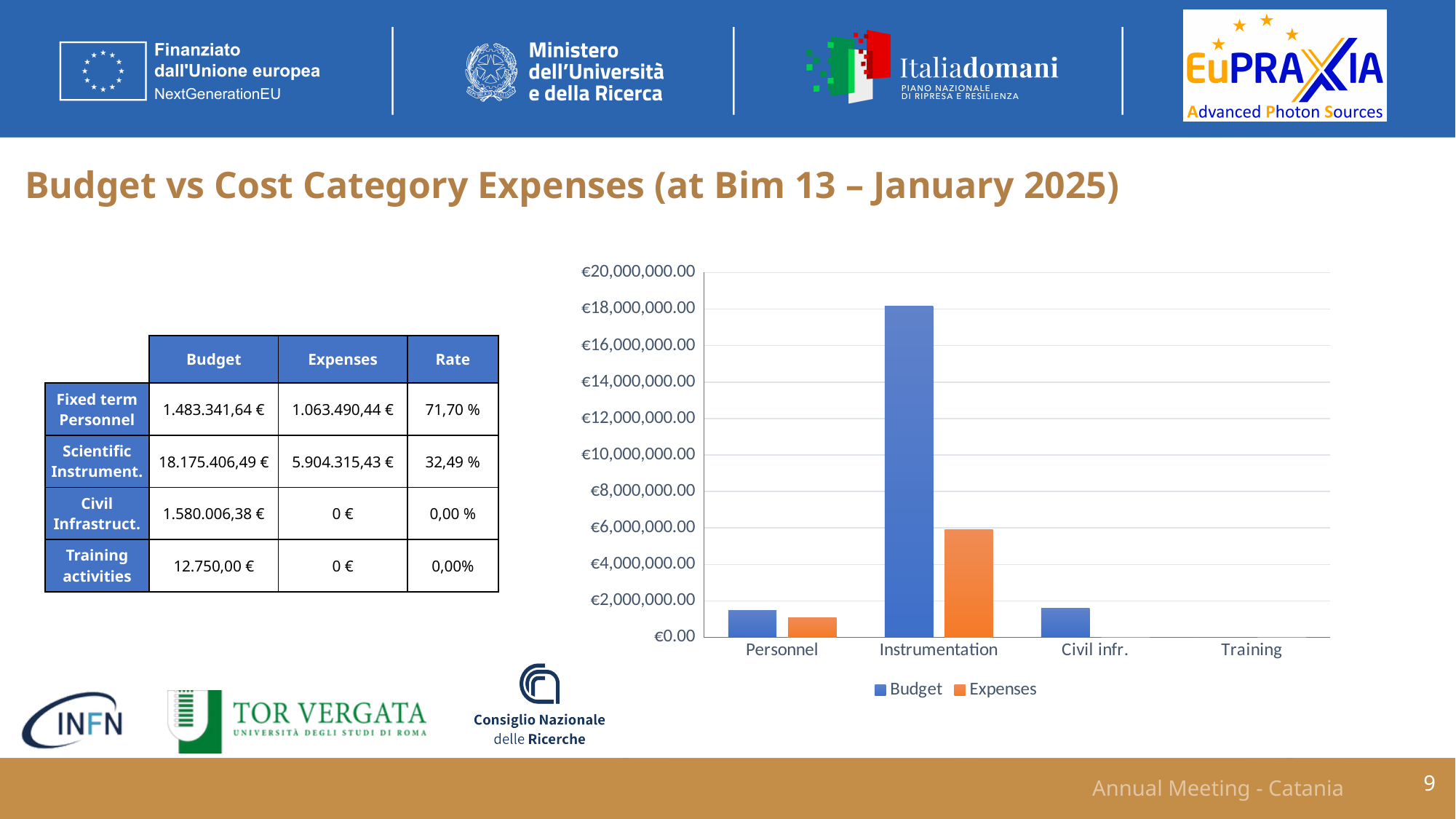
For Personnel, which is larger: the Budget bar or the Expenses bar? Budget Which category has the lowest Budget bar in the chart? Training Which category has the highest Budget bar in the chart? Instrumentation How many categories are shown on the x axis of the chart? 4 Is the Budget value for Instrumentation greater or less than €16,000,000.00? greater Which is larger: the Expenses bar for Instrumentation or the Budget bar for Civil infr.? Expenses for Instrumentation According to the table on the slide, what is the Budget for Scientific Instrument.? 18.175.406,49 € What kind of chart is shown on the slide? bar chart What colour are the Expenses bars in the chart? orange Is the Budget value for Personnel greater or less than €2,000,000.00? less How many series does the chart legend list? 2 Is the Expenses value for Instrumentation greater or less than €8,000,000.00? less